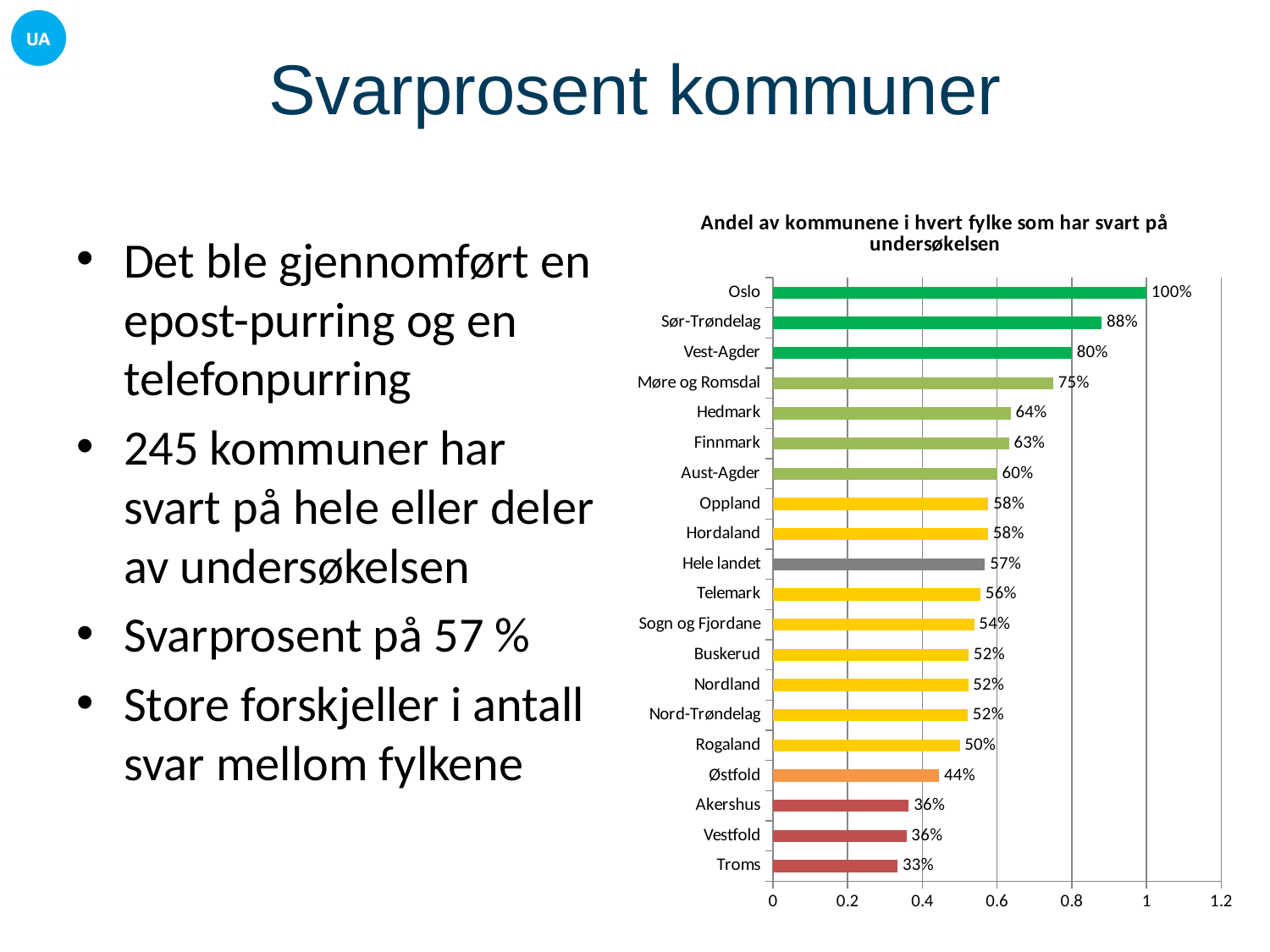
What is the value for Møre og Romsdal? 75% Which category has the lowest value? Troms Which is larger, the value for Hedmark or the value for Rogaland? Hedmark Is the value for Akershus greater or less than 0.4? less What is the title of the chart? Andel av kommunene i hvert fylke som har svart på undersøkelsen What is the value for Hele landet? 57% What is the value for Østfold? 44% Which category has the highest value? Oslo What is the value for Oslo? 100% What kind of chart is shown on the slide? bar chart What is the difference between the values for Sør-Trøndelag and Vest-Agder? 8% How many categories are shown in the chart? 20